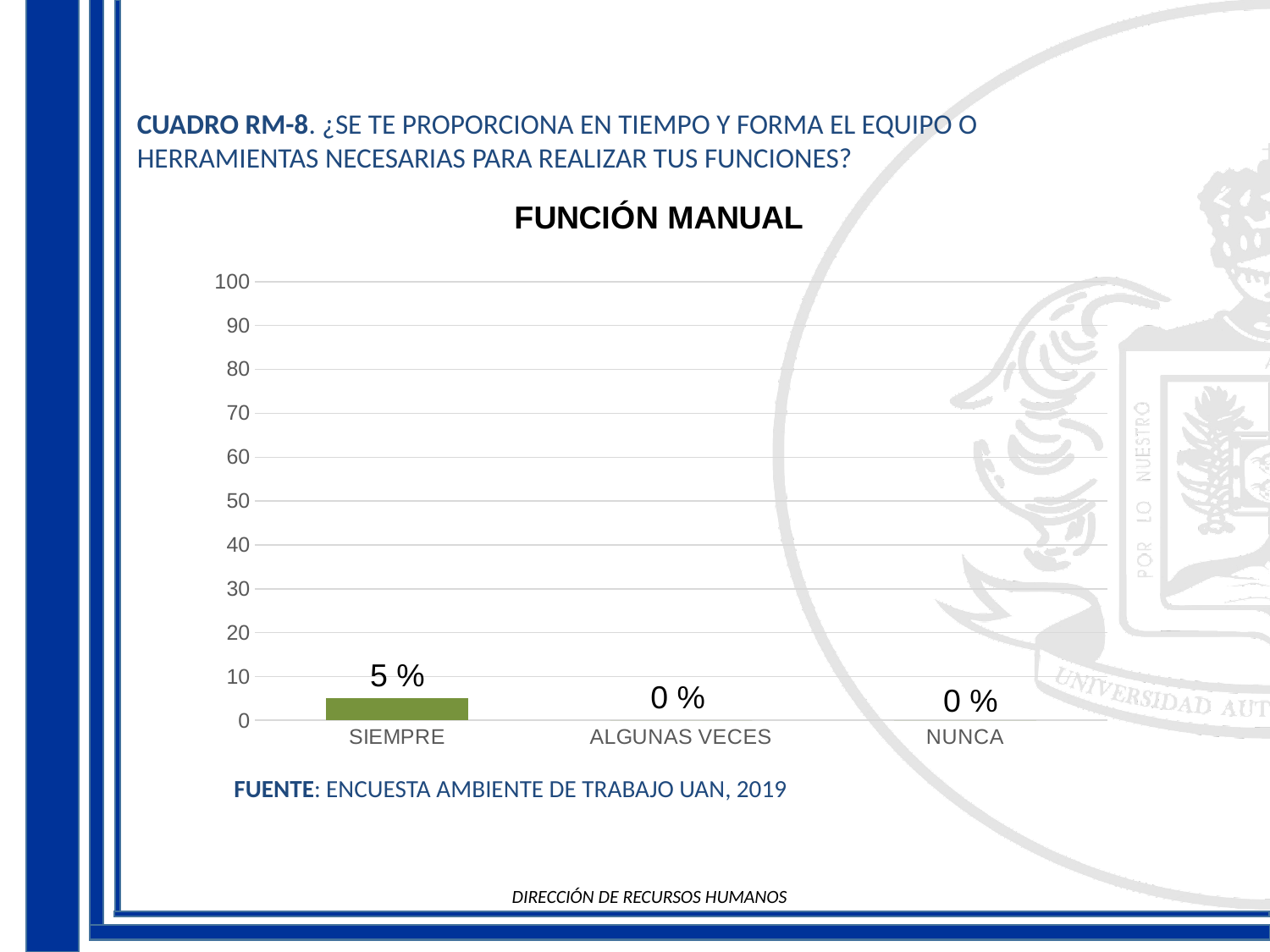
What is the value for SIEMPRE? 5 % What is the difference between the values for SIEMPRE and NUNCA? 5 % What is the value for NUNCA? 0 % What is the value for ALGUNAS VECES? 0 % Which is larger, the value for SIEMPRE or the value for ALGUNAS VECES? SIEMPRE Do the values rise or fall from SIEMPRE to NUNCA? fall What is the maximum value shown on the vertical axis? 100 Which category has the highest value? SIEMPRE Is the value for SIEMPRE greater or less than 10? less What is the title of the chart? FUNCIÓN MANUAL What kind of chart is shown? bar chart How many categories are shown on the x axis? 3